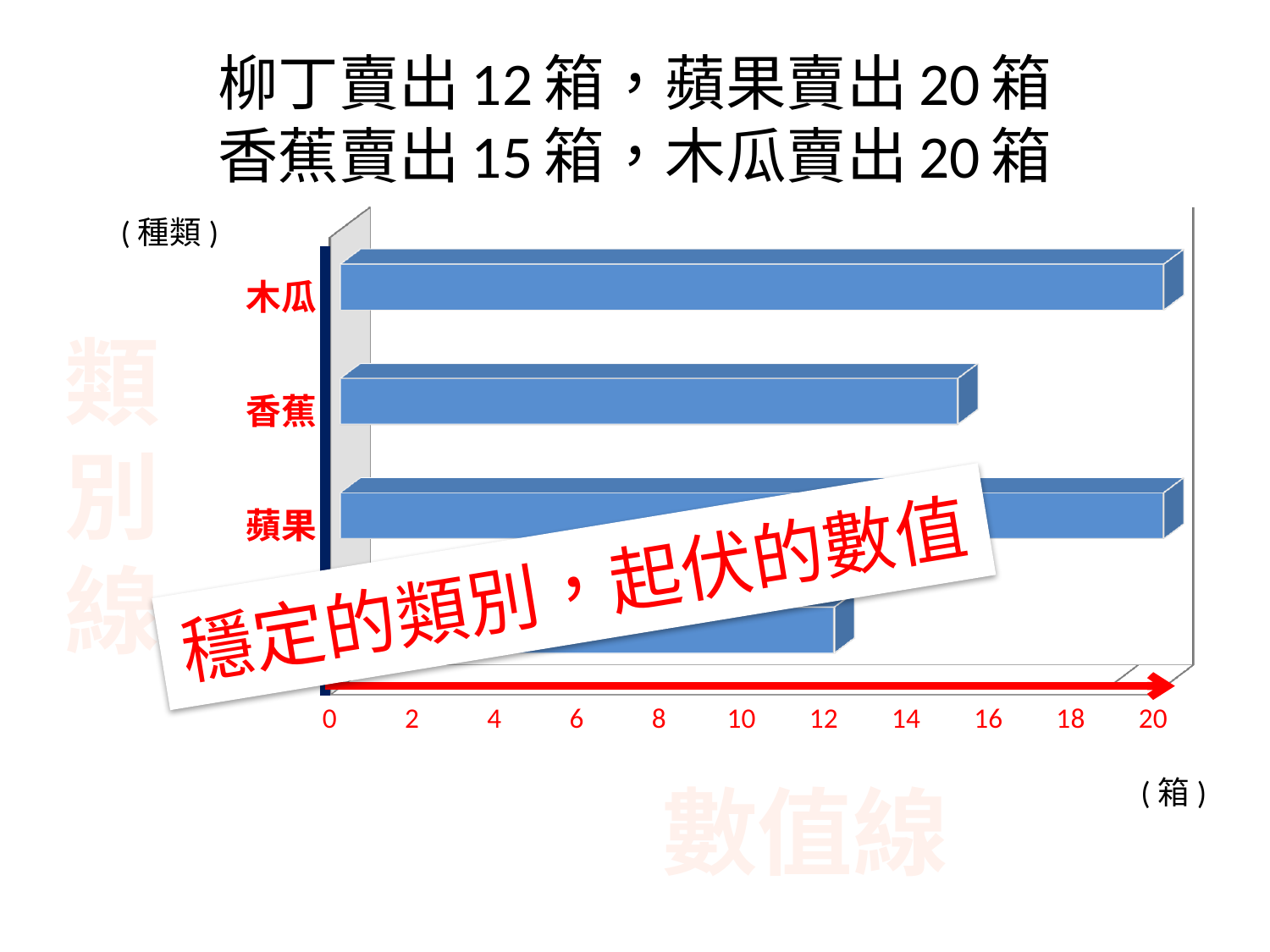
What is the highest tick value shown on the horizontal axis? 20 Which is larger, the value for 蘋果 or the value for 香蕉? 蘋果 What is the value for 木瓜? 20 What kind of chart is shown on the slide? bar chart Is the value for 木瓜 greater or less than 18? greater How many bars are plotted in the chart? 4 What is the value for 蘋果? 20 Is the value for 香蕉 greater or less than 14? greater What unit is shown for the horizontal axis of the chart? 箱 What is the value for 香蕉? 15 Among 木瓜, 香蕉 and 蘋果, which category has the lowest value? 香蕉 What is the difference between the values for 木瓜 and 香蕉? 5